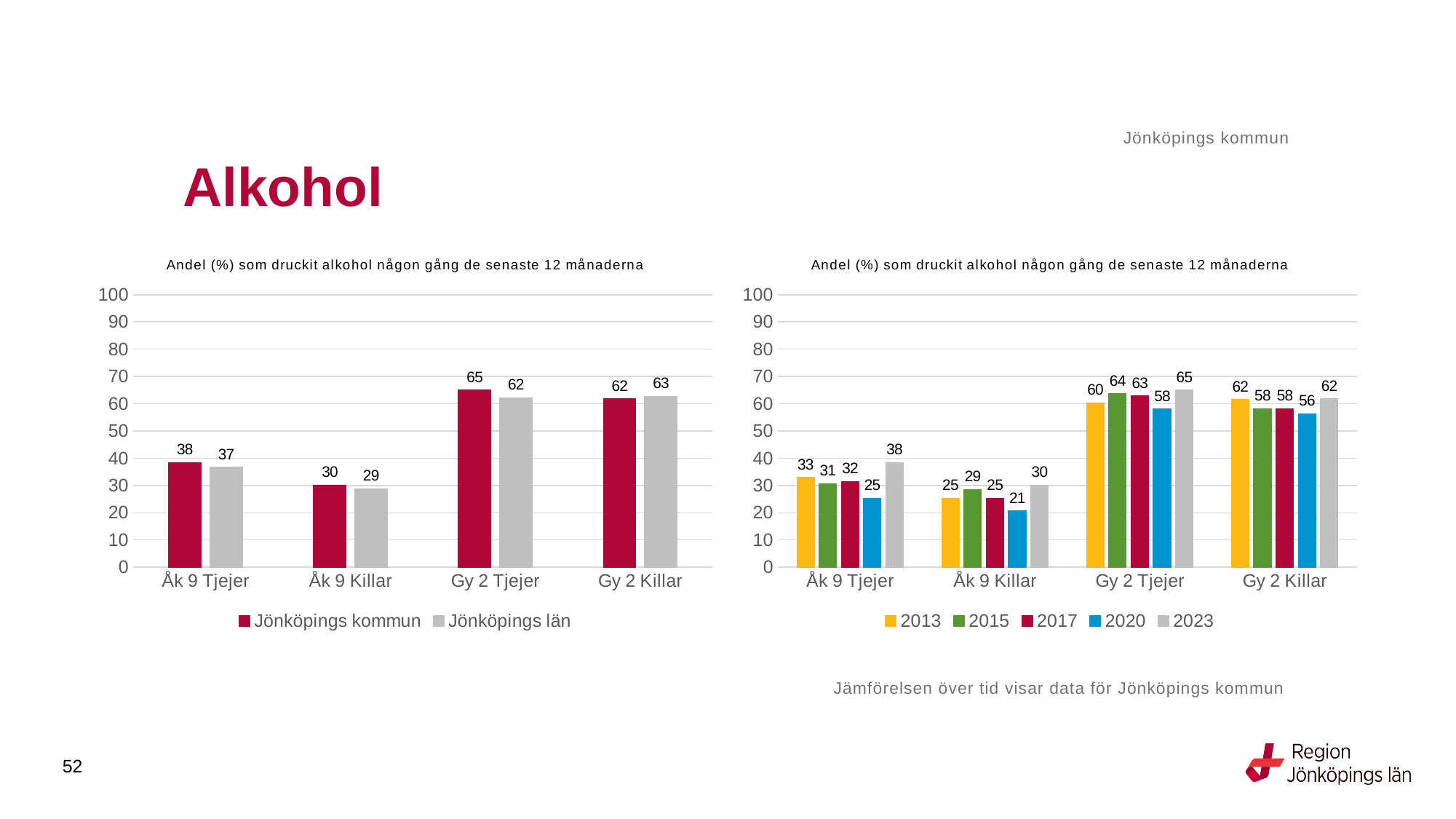
In the right chart, how many series does the legend list? 5 In the right chart, what is the difference between the 2023 and 2020 values for Åk 9 Tjejer? 13 In the right chart, what is the value for 2015 for Gy 2 Tjejer? 64 What kind of chart is the left chart? Bar chart In the right chart, what is the value for 2020 for Åk 9 Killar? 21 In the right chart, which year has the highest value for Åk 9 Tjejer? 2023 In the left chart, how many series does the legend list? 2 In the left chart, which category has the lowest value for Jönköpings län? Åk 9 Killar In the right chart, which is larger for Gy 2 Killar: the value for 2013 or the value for 2020? 2013 In the left chart, what is the value for Jönköpings län for Gy 2 Killar? 63 In the left chart, what is the value for Jönköpings kommun for Åk 9 Tjejer? 38 In the left chart, what is the difference between Jönköpings kommun and Jönköpings län for Gy 2 Tjejer? 3